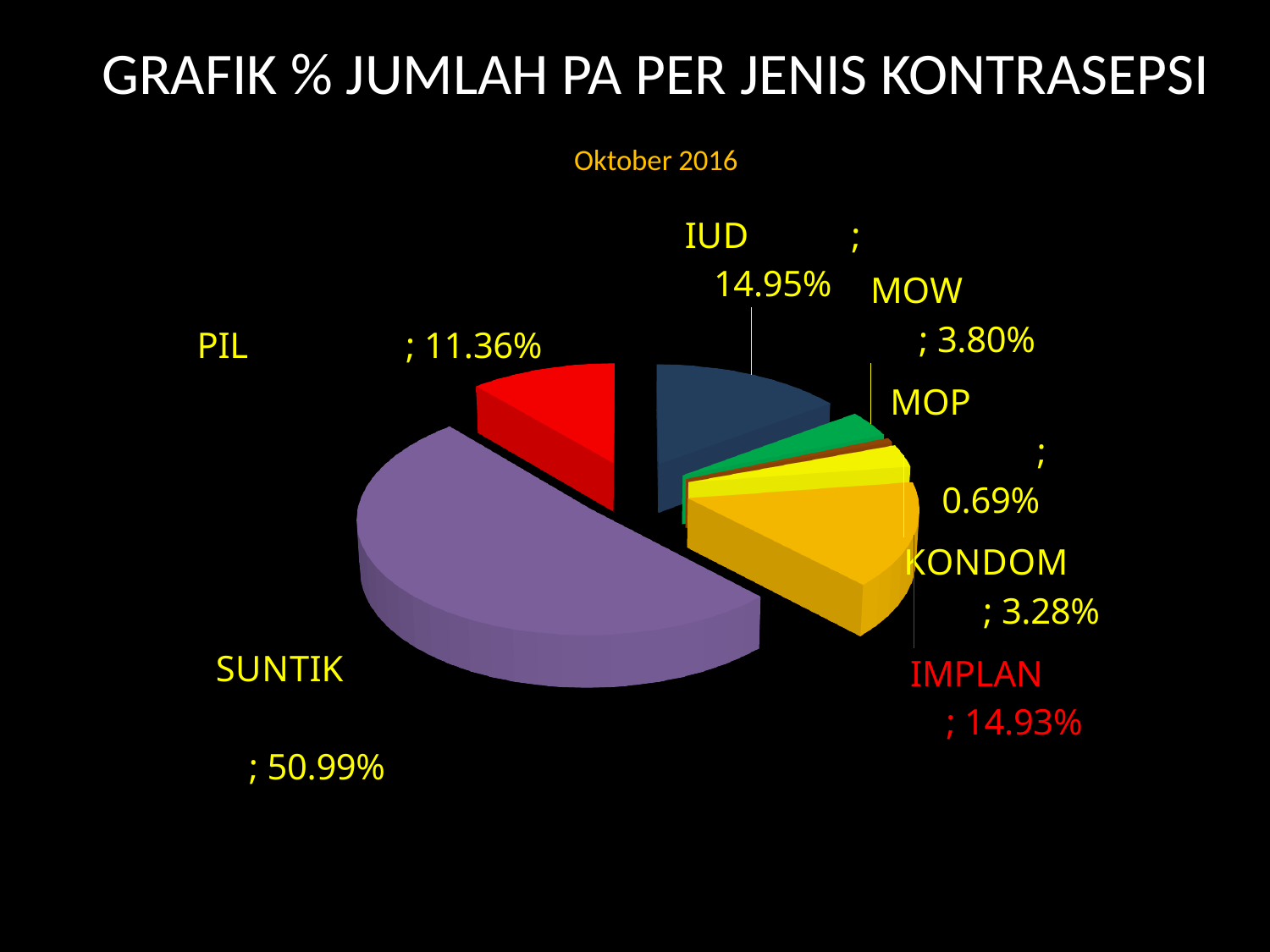
What percentage is shown for SUNTIK? 50.99% Which category has the smallest share of the pie? MOP How many categories are shown in the pie chart? 7 What percentage is shown for KONDOM? 3.28% What is the difference between the shares of SUNTIK and PIL? 39.63% What percentage is shown for IUD? 14.95% Which category has the largest share of the pie? SUNTIK What percentage is shown for PIL? 11.36% What type of chart is shown on the slide? Pie chart Which has a larger share, PIL or MOW? PIL What percentage is shown for MOP? 0.69% What is the title shown above the pie chart? Oktober 2016